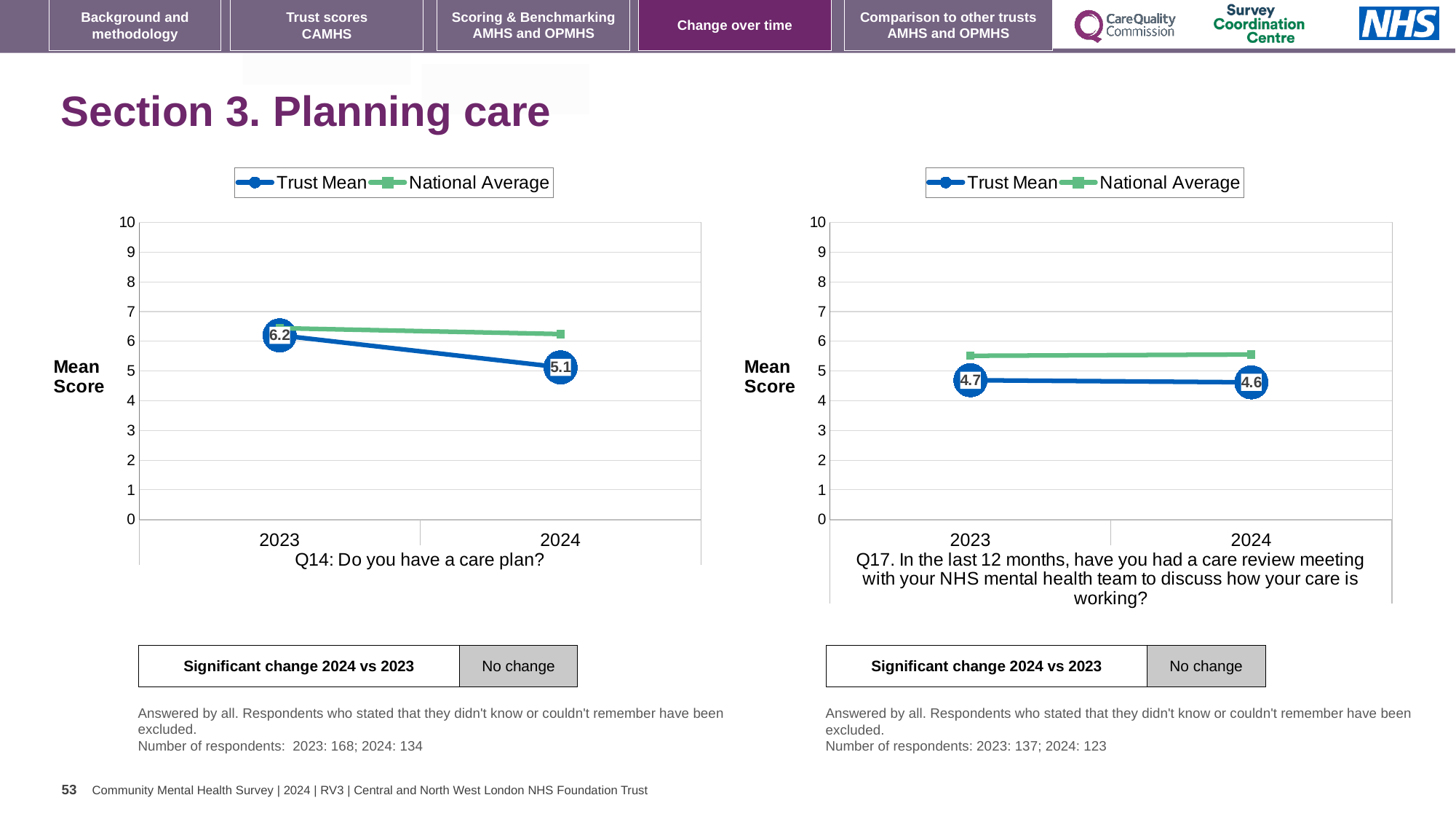
How many series does the legend of the left chart list? 2 In the left chart (Q14: Do you have a care plan?), what is the Trust Mean score for 2024? 5.1 In the left chart (Q14), which is higher in 2024, the Trust Mean or the National Average? National Average In the right chart (Q17, care review meeting), what is the Trust Mean score for 2024? 4.6 How many years are plotted on the x axis of the left chart (Q14)? 2 In the left chart (Q14: Do you have a care plan?), what is the Trust Mean score for 2023? 6.2 What type of chart is used for Q17 on the right of the slide? line chart In the right chart (Q17), what is the difference between the Trust Mean scores for 2023 and 2024? 0.1 In the right chart (Q17, care review meeting), what is the Trust Mean score for 2023? 4.7 In the right chart (Q17), is the National Average value for 2024 greater or less than 5? greater In the left chart (Q14), by how much did the Trust Mean score fall from 2023 to 2024? 1.1 In the left chart (Q14), does the Trust Mean rise or fall from 2023 to 2024? fall